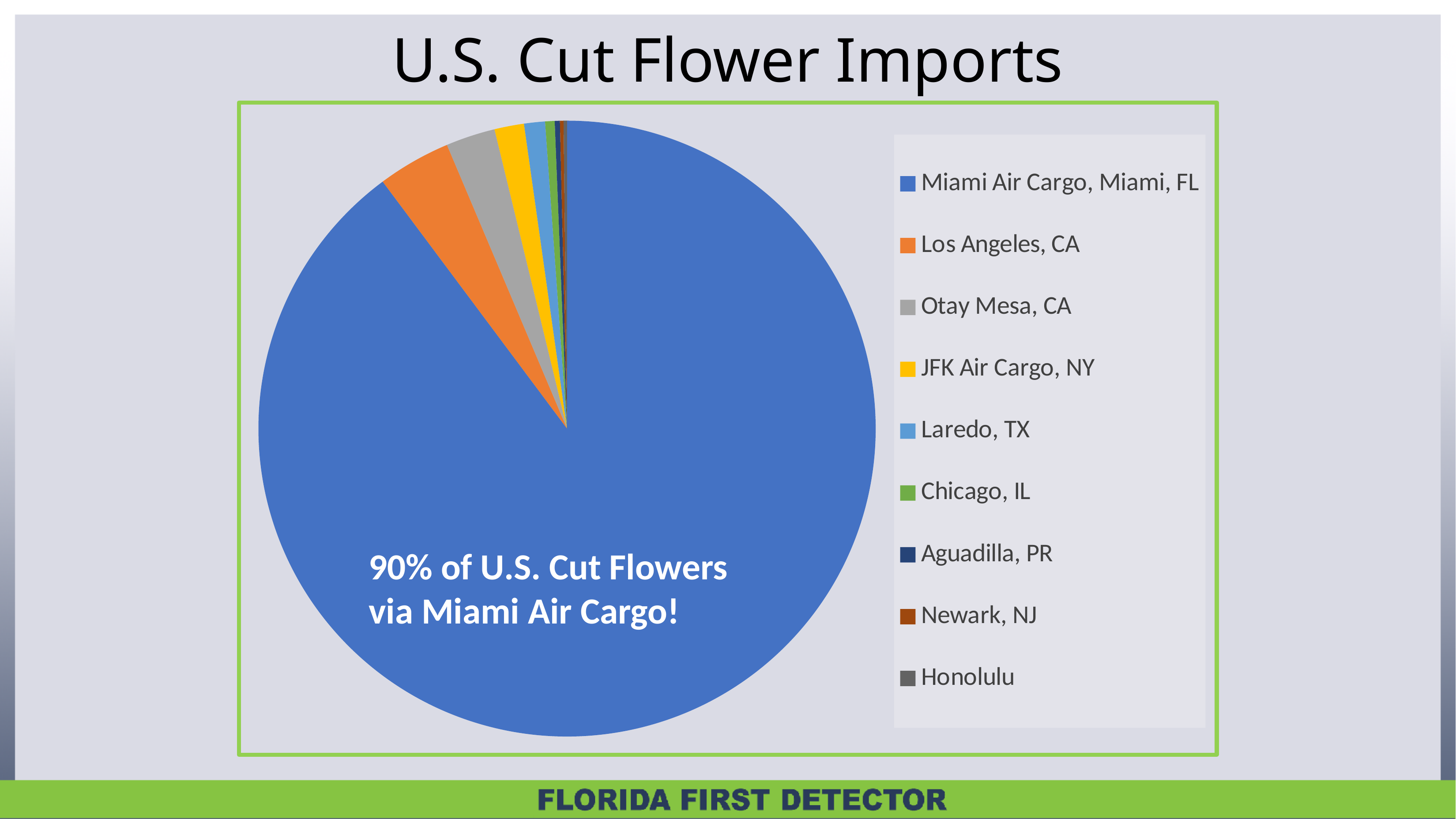
What share of U.S. cut flowers comes in via Miami Air Cargo, according to the text on the chart? 90% Which port accounts for the largest share of U.S. cut flower imports? Miami Air Cargo, Miami, FL Which is larger: the slice for Los Angeles, CA or the slice for Otay Mesa, CA? Los Angeles, CA Is the share for Miami Air Cargo, Miami, FL greater or less than 50%? greater What is the title of the chart? U.S. Cut Flower Imports Which port has the second-largest slice of the pie? Los Angeles, CA Which is larger: the slice for Los Angeles, CA or the slice for Laredo, TX? Los Angeles, CA How many categories does the legend list? 9 Which colour represents Miami Air Cargo, Miami, FL in the chart? blue Which is larger: the slice for Miami Air Cargo, Miami, FL or the slice for JFK Air Cargo, NY? Miami Air Cargo, Miami, FL What kind of chart is shown on the slide? pie chart